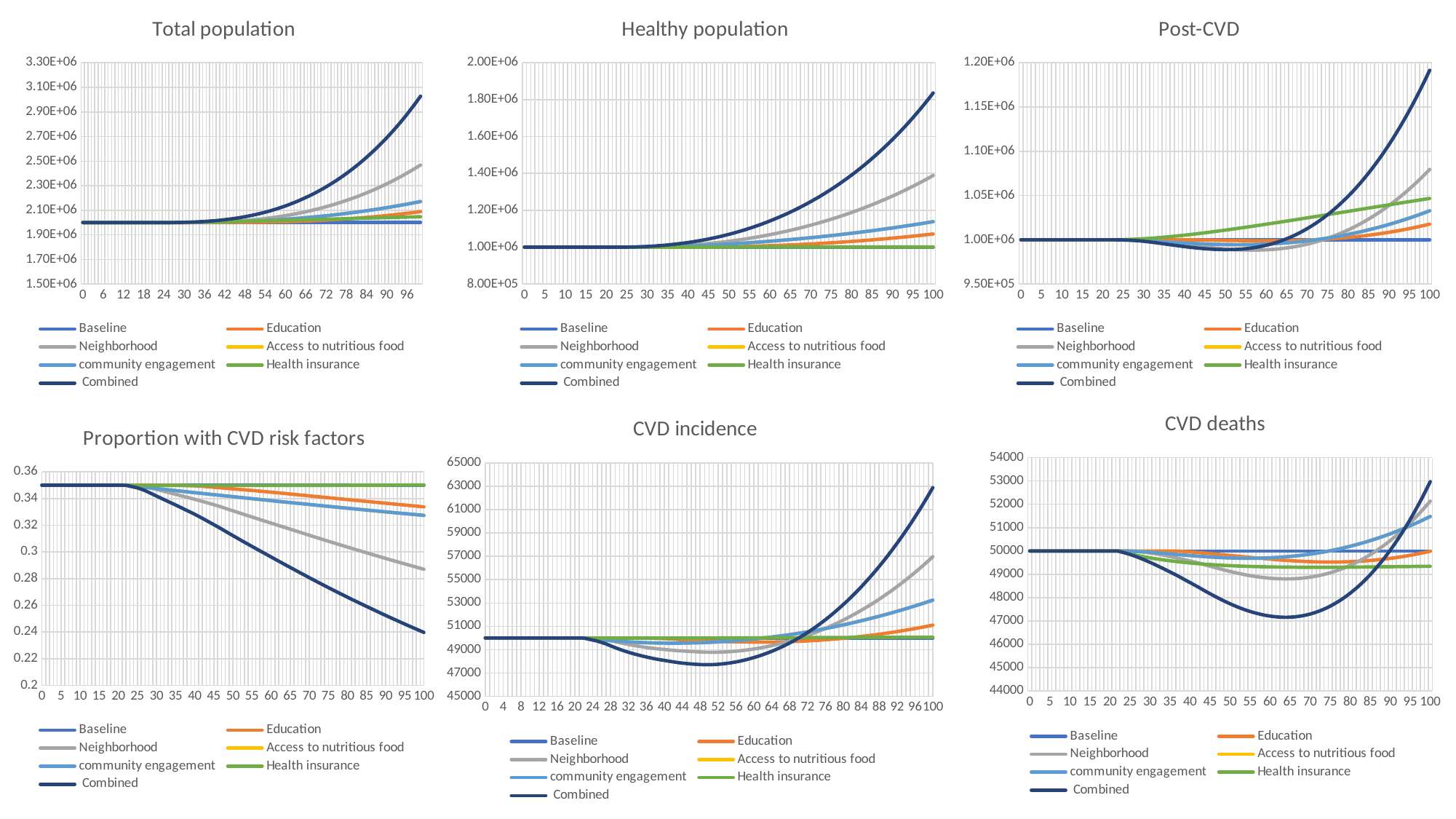
In the "Proportion with CVD risk factors" chart, which series is lowest at 100? Combined In the "Healthy population" chart, is the Combined value at 100 greater or less than 1.60E+06? greater How many series does the legend of the "Healthy population" chart list? 7 In the "Proportion with CVD risk factors" chart, does the Combined series rise or fall from 25 to 100 along the x axis? fall What kind of chart is the "Total population" chart? line chart In the "Proportion with CVD risk factors" chart, is the Combined value at 100 greater or less than 0.26? less How many charts are shown on the slide? 6 In the "CVD incidence" chart, is the Combined value at 100 greater or less than 61000? greater In the "Total population" chart, which series is highest at the right end of the x axis? Combined In the "CVD deaths" chart, which is larger at 100: Combined or Neighborhood? Combined